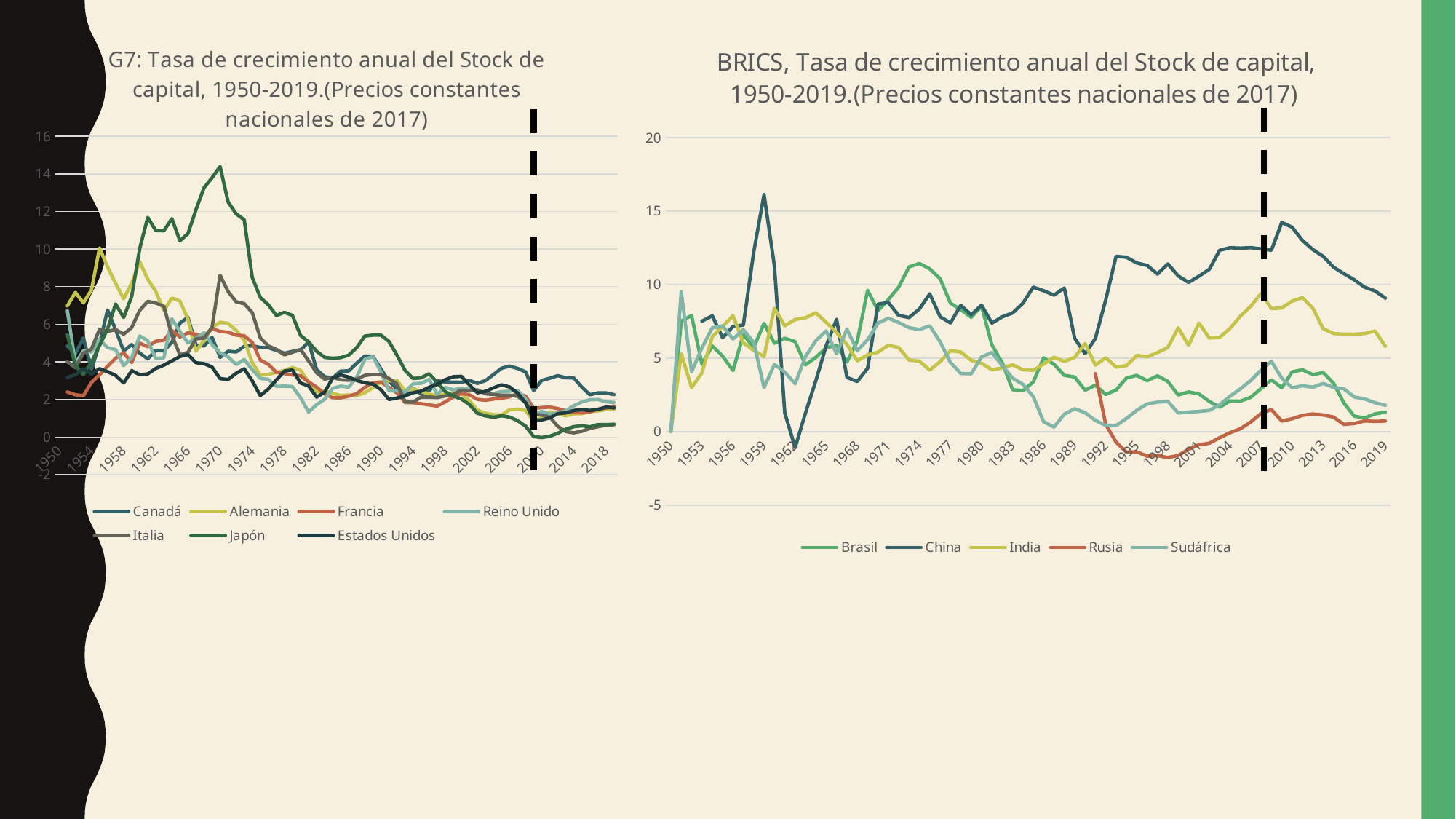
What kind of chart is the G7 chart on the left? line chart In the BRICS chart, which country's line reaches the highest value around 1960? China What kind of chart is the BRICS chart on the right? line chart How many series does the legend of the BRICS chart list? 5 In the BRICS chart, which country has the highest value in 2019? China In the BRICS chart, is the value for China in 2009 greater or less than 10? greater In the G7 chart, does the line for Japón rise or fall from 1970 to 2019? fall In the G7 chart, is the value for Japón in 1970 greater or less than 12? greater In the BRICS chart, is the value for Rusia in 1998 greater or less than 0? less How many series does the legend of the G7 chart list? 7 In the G7 chart, which country's line reaches the highest value around 1970? Japón Which countries are listed in the legend of the BRICS chart? Brasil, China, India, Rusia, Sudáfrica